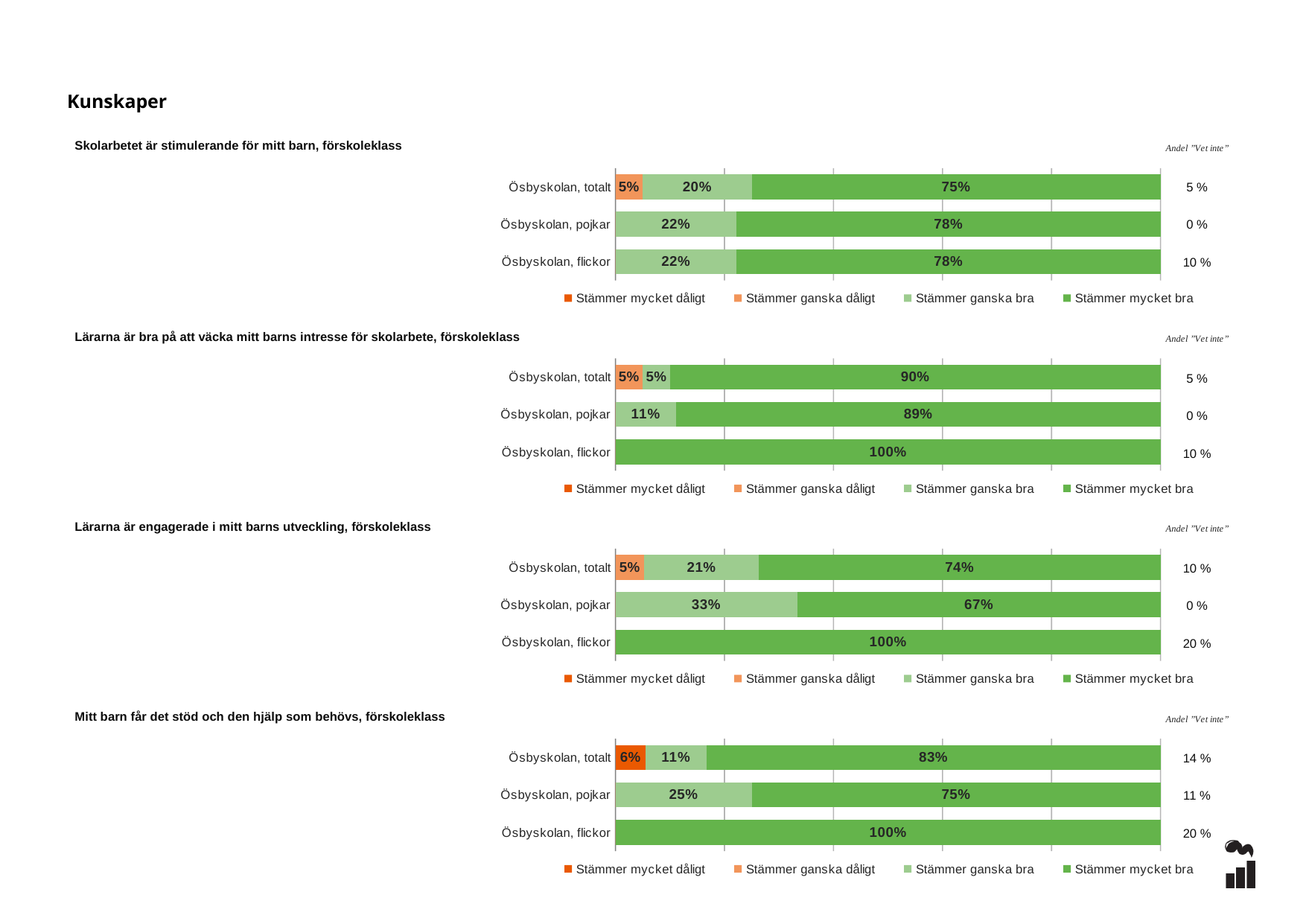
In the chart "Mitt barn får det stöd och den hjälp som behövs, förskoleklass", which is larger: "Stämmer mycket bra" for Ösbyskolan, totalt or for Ösbyskolan, pojkar? Ösbyskolan, totalt In the chart "Mitt barn får det stöd och den hjälp som behövs, förskoleklass", what is the "Andel Vet inte" value for Ösbyskolan, flickor? 20 % In the chart "Lärarna är engagerade i mitt barns utveckling, förskoleklass", which category has the lowest value for "Stämmer mycket bra"? Ösbyskolan, pojkar In the chart "Lärarna är bra på att väcka mitt barns intresse för skolarbete, förskoleklass", what is the value of "Stämmer mycket bra" for Ösbyskolan, flickor? 100% What kind of chart is "Lärarna är engagerade i mitt barns utveckling, förskoleklass"? Stacked bar chart In the chart "Lärarna är bra på att väcka mitt barns intresse för skolarbete, förskoleklass", which category has the highest value for "Stämmer mycket bra"? Ösbyskolan, flickor In the chart "Lärarna är engagerade i mitt barns utveckling, förskoleklass", what is the value of "Stämmer ganska bra" for Ösbyskolan, pojkar? 33% In the chart "Lärarna är engagerade i mitt barns utveckling, förskoleklass", what is the difference between "Stämmer mycket bra" for Ösbyskolan, totalt and Ösbyskolan, pojkar? 7% In the chart "Skolarbetet är stimulerande för mitt barn, förskoleklass", what is the value of "Stämmer ganska bra" for Ösbyskolan, pojkar? 22% How many series does the legend list in the chart "Skolarbetet är stimulerande för mitt barn, förskoleklass"? 4 In the chart "Skolarbetet är stimulerande för mitt barn, förskoleklass", what is the value of "Stämmer mycket bra" for Ösbyskolan, totalt? 75% In the chart "Mitt barn får det stöd och den hjälp som behövs, förskoleklass", what is the value of "Stämmer mycket dåligt" for Ösbyskolan, totalt? 6%